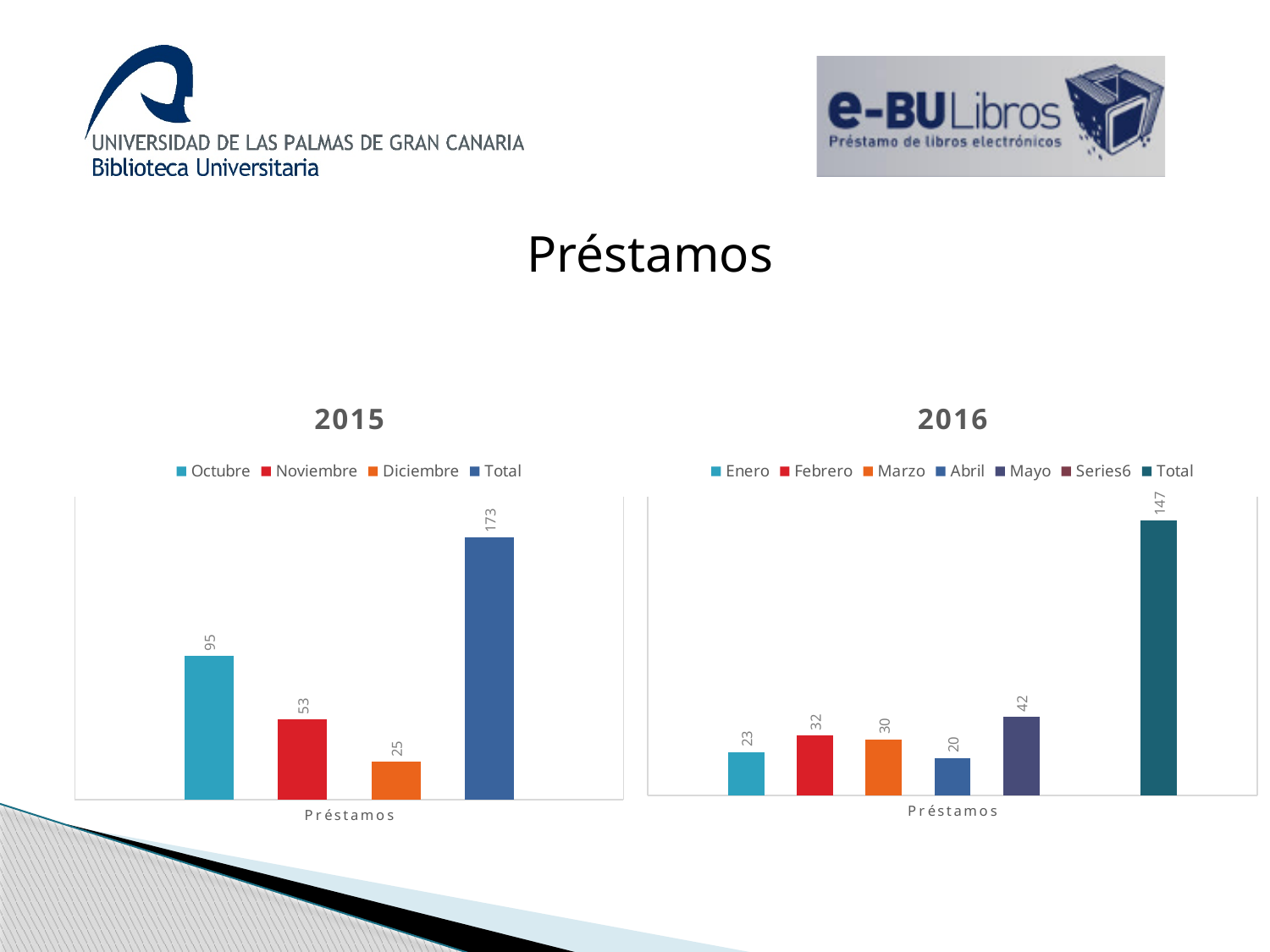
In the 2015 chart, what is the value for Octubre? 95 How many entries does the legend of the 2016 chart list? 7 In the 2016 chart, what is the value for Mayo? 42 In the 2015 chart, what is the value for Diciembre? 25 In the 2016 chart, which month (excluding Total) has the highest value? Mayo What type of chart is the 2015 chart? Bar chart In the 2016 chart, what is the value for Abril? 20 In the 2016 chart, which is larger, Febrero or Marzo? Febrero In the 2015 chart, which month (excluding Total) has the lowest value? Diciembre In the 2015 chart, what is the value of the Total bar? 173 In the 2015 chart, what is the difference between Octubre and Noviembre? 42 In the 2016 chart, what is the difference between the Total bar and Mayo? 105